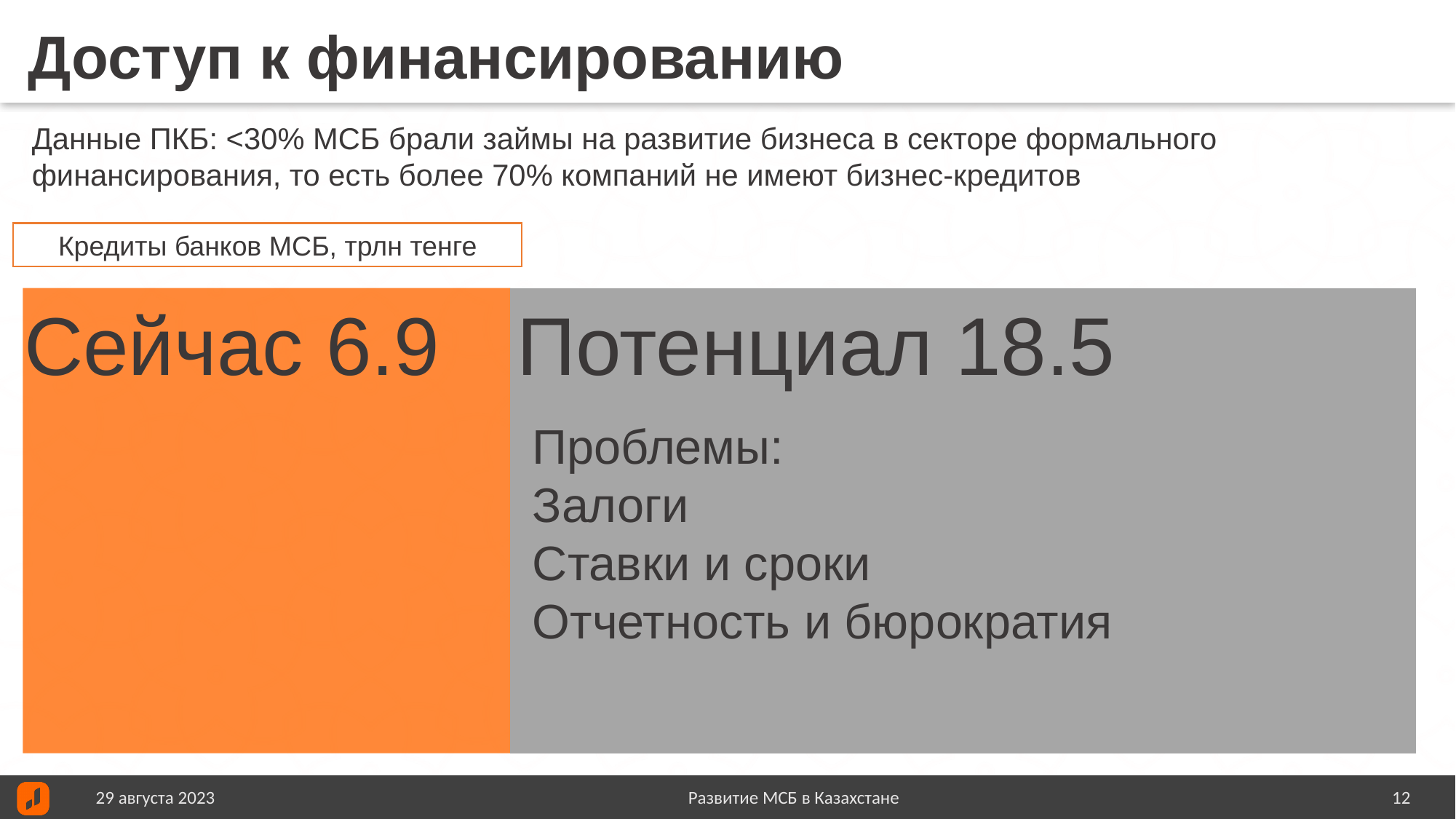
How many categories are shown in the chart? 2 What is the title of the chart? Кредиты банков МСБ, трлн тенге In what units are the chart values given? трлн тенге What is the value for "Потенциал" in the chart "Кредиты банков МСБ, трлн тенге"? 18.5 Which category has the lowest value in the chart? Сейчас Which category has the highest value in the chart? Потенциал What is the difference between the "Потенциал" value and the "Сейчас" value? 11.6 What is the value for "Сейчас" in the chart "Кредиты банков МСБ, трлн тенге"? 6.9 What colour is the "Сейчас" segment of the chart? Orange Which category has the higher value, "Сейчас" or "Потенциал"? Потенциал What kind of chart is shown on the slide? Bar chart